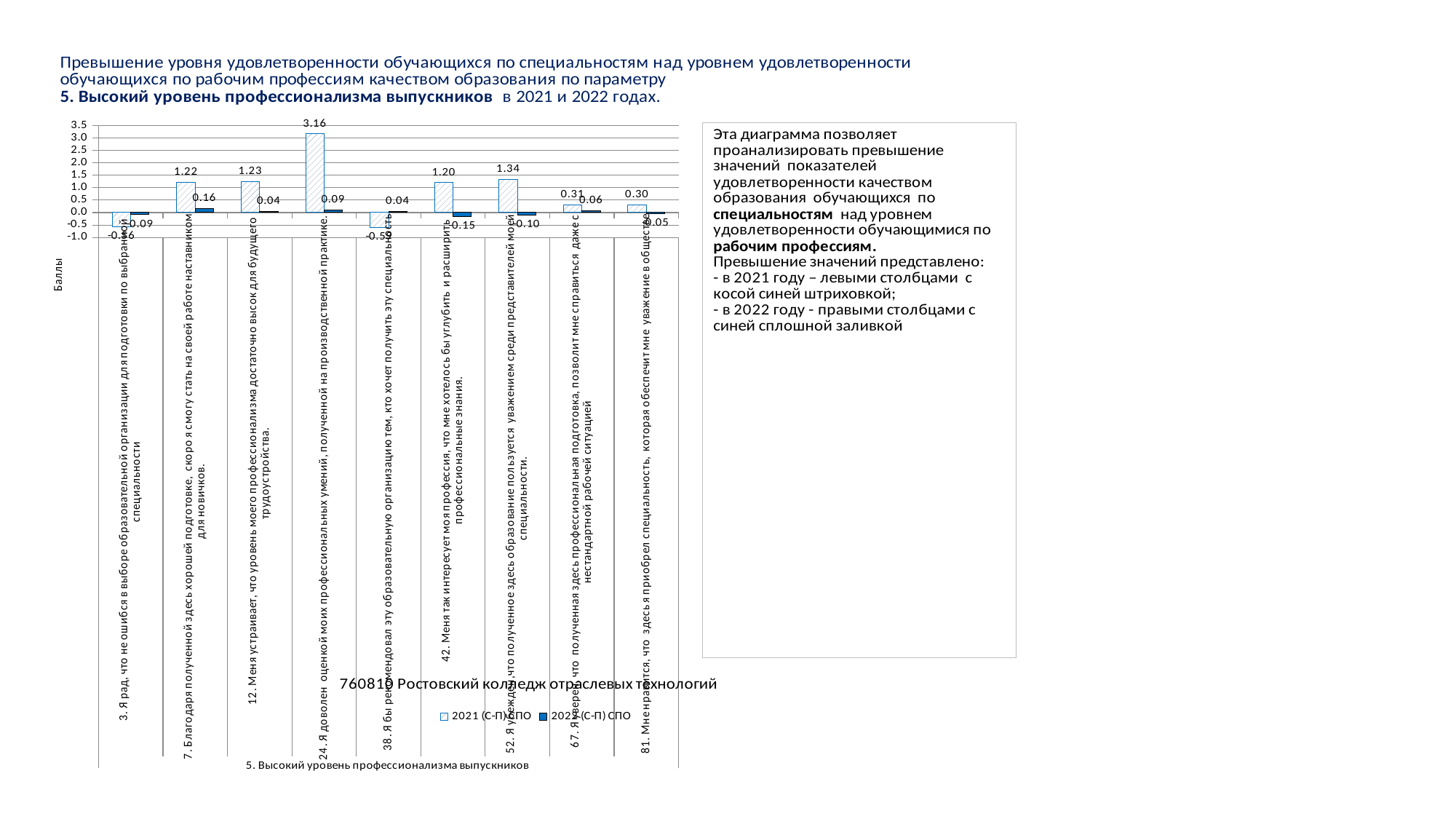
How many series does the chart legend list? 2 What is the 2021 (С-П) СПО value for statement 38 ("Я бы рекомендовал эту образовательную организацию...")? -0.59 What is the 2022 (С-П) СПО value for statement 7 ("Благодаря полученной здесь хорошей подготовке...")? 0.16 What type of chart is shown on the slide? bar chart What is the label of the vertical axis of the chart? Баллы What is the difference between the 2021 and 2022 (С-П) СПО values for statement 52? 1.44 Which statement has the highest 2021 (С-П) СПО value? 24. Я доволен оценкой моих профессиональных умений, полученной на производственной практике Which statement has the lowest 2021 (С-П) СПО value? 38. Я бы рекомендовал эту образовательную организацию тем, кто хочет получить эту специальность How many categories (statements) are plotted on the x axis of the chart? 9 What is the 2021 (С-П) СПО value for statement 24 ("Я доволен оценкой моих профессиональных умений...")? 3.16 For statement 42, which series has the larger value: 2021 (С-П) СПО or 2022 (С-П) СПО? 2021 (С-П) СПО What is the 2022 (С-П) СПО value for statement 81 ("Мне нравится, что здесь я приобрел специальность...")? -0.05